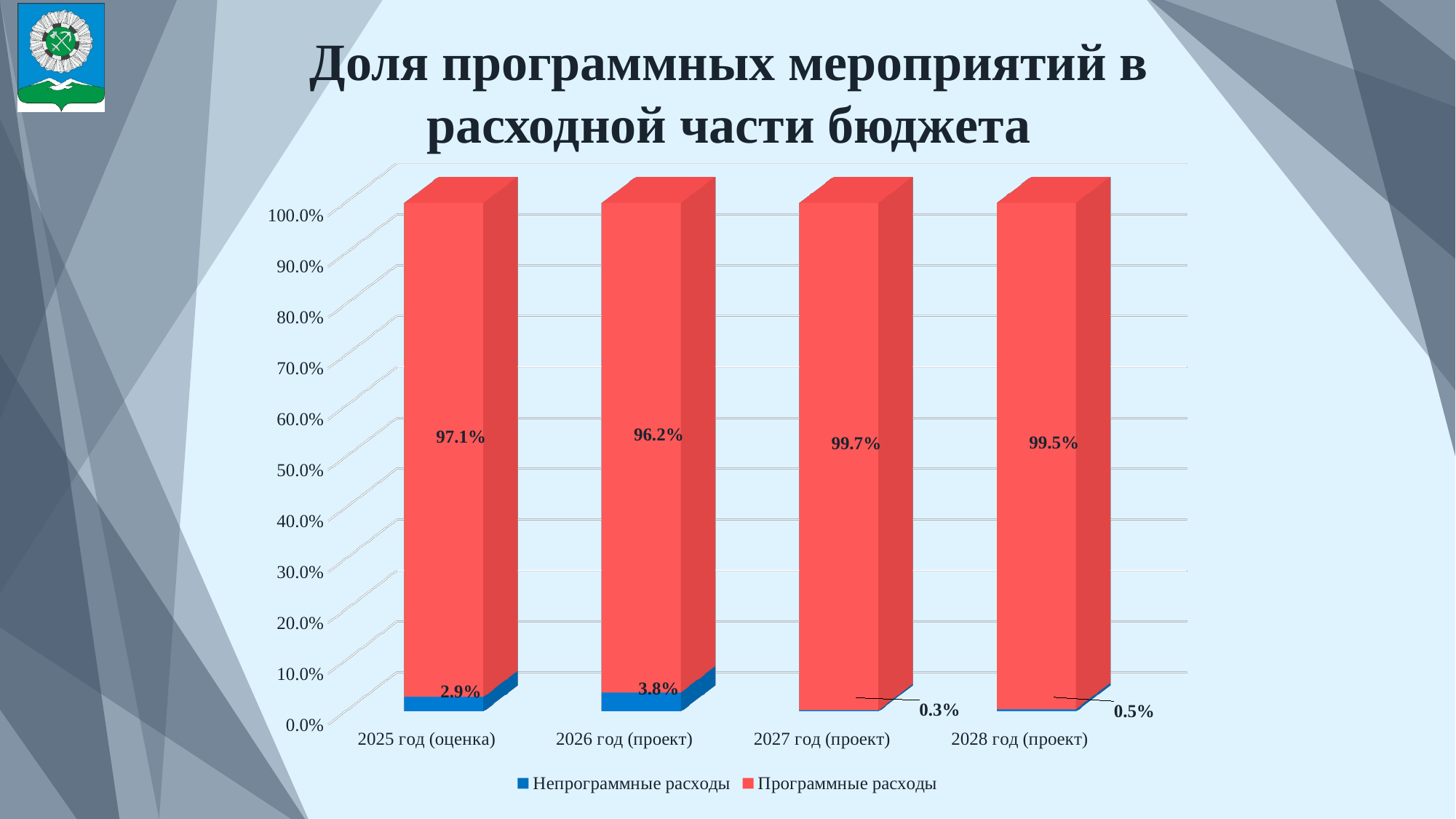
What is the value of Программные расходы for 2028 год (проект)? 99.5% What is the value of Программные расходы for 2025 год (оценка)? 97.1% How many series does the legend list? 2 How many years (categories) are shown on the x axis? 4 What is the total of the stacked bar for 2026 год (проект)? 100% Which year has the highest value for Непрограммные расходы? 2026 год (проект) What is the difference between Программные расходы in 2025 год (оценка) and 2026 год (проект)? 0.9% What is the value of Непрограммные расходы for 2027 год (проект)? 0.3% What is the value of Непрограммные расходы for 2026 год (проект)? 3.8% Which year has the lowest value for Непрограммные расходы? 2027 год (проект) Which year has the highest value for Программные расходы? 2027 год (проект) Which is larger: Непрограммные расходы in 2025 год (оценка) or in 2028 год (проект)? 2025 год (оценка)